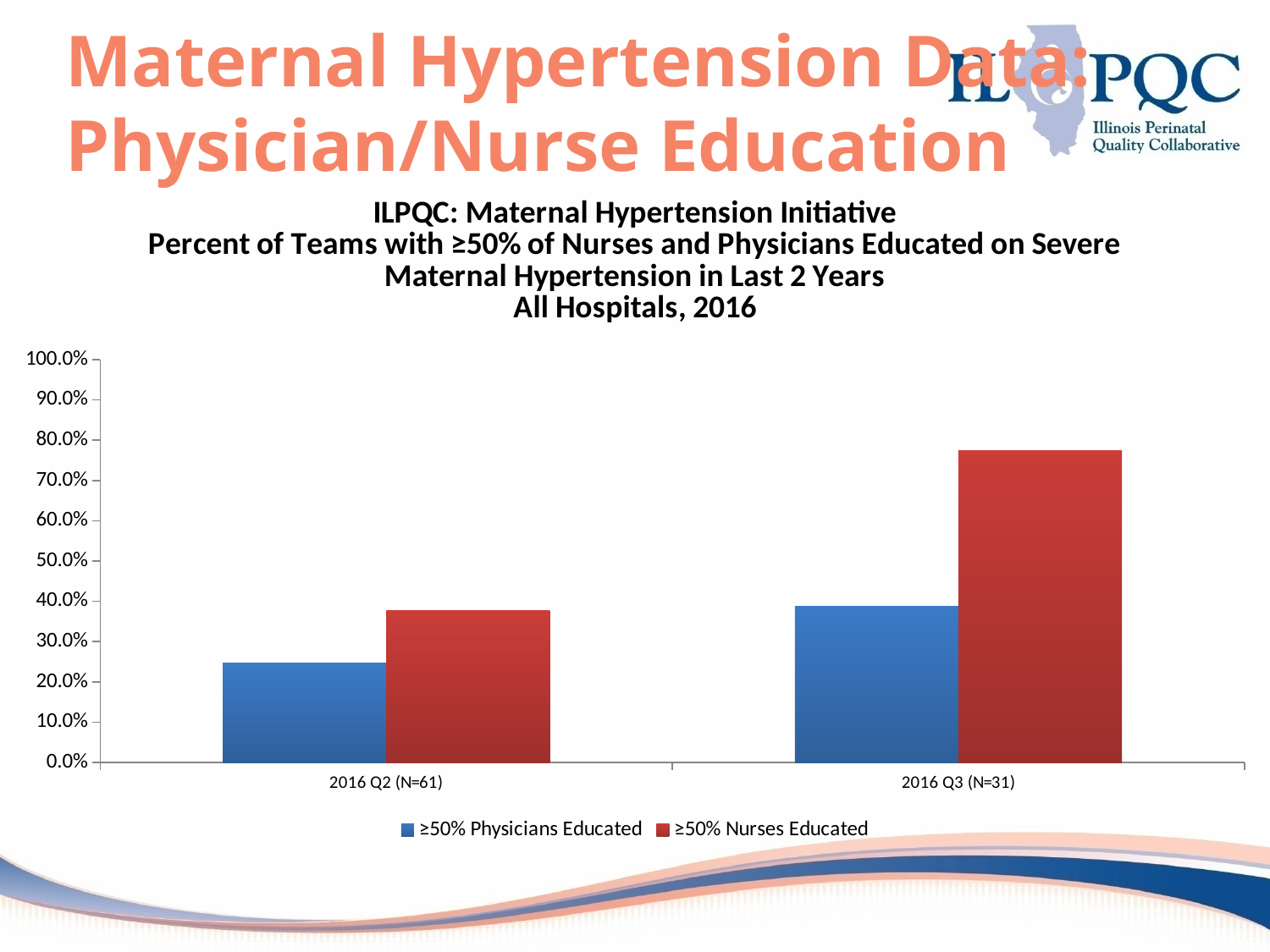
What kind of chart is shown on the slide? Bar chart Is the value for ≥50% Nurses Educated in 2016 Q3 (N=31) greater or less than 70.0%? greater Which bar is the lowest in the chart? ≥50% Physicians Educated in 2016 Q2 (N=61) How many series does the chart legend list? 2 Is the value for ≥50% Physicians Educated in 2016 Q2 (N=61) greater or less than 30.0%? less Is the value for ≥50% Physicians Educated in 2016 Q3 (N=31) greater or less than 50.0%? less In 2016 Q2 (N=61), which is larger: ≥50% Physicians Educated or ≥50% Nurses Educated? ≥50% Nurses Educated Which colour represents ≥50% Physicians Educated in the legend? Blue Do the values for ≥50% Nurses Educated rise or fall from 2016 Q2 to 2016 Q3? rise Which bar is the highest in the chart? ≥50% Nurses Educated in 2016 Q3 (N=31) How many quarter categories are shown on the x axis? 2